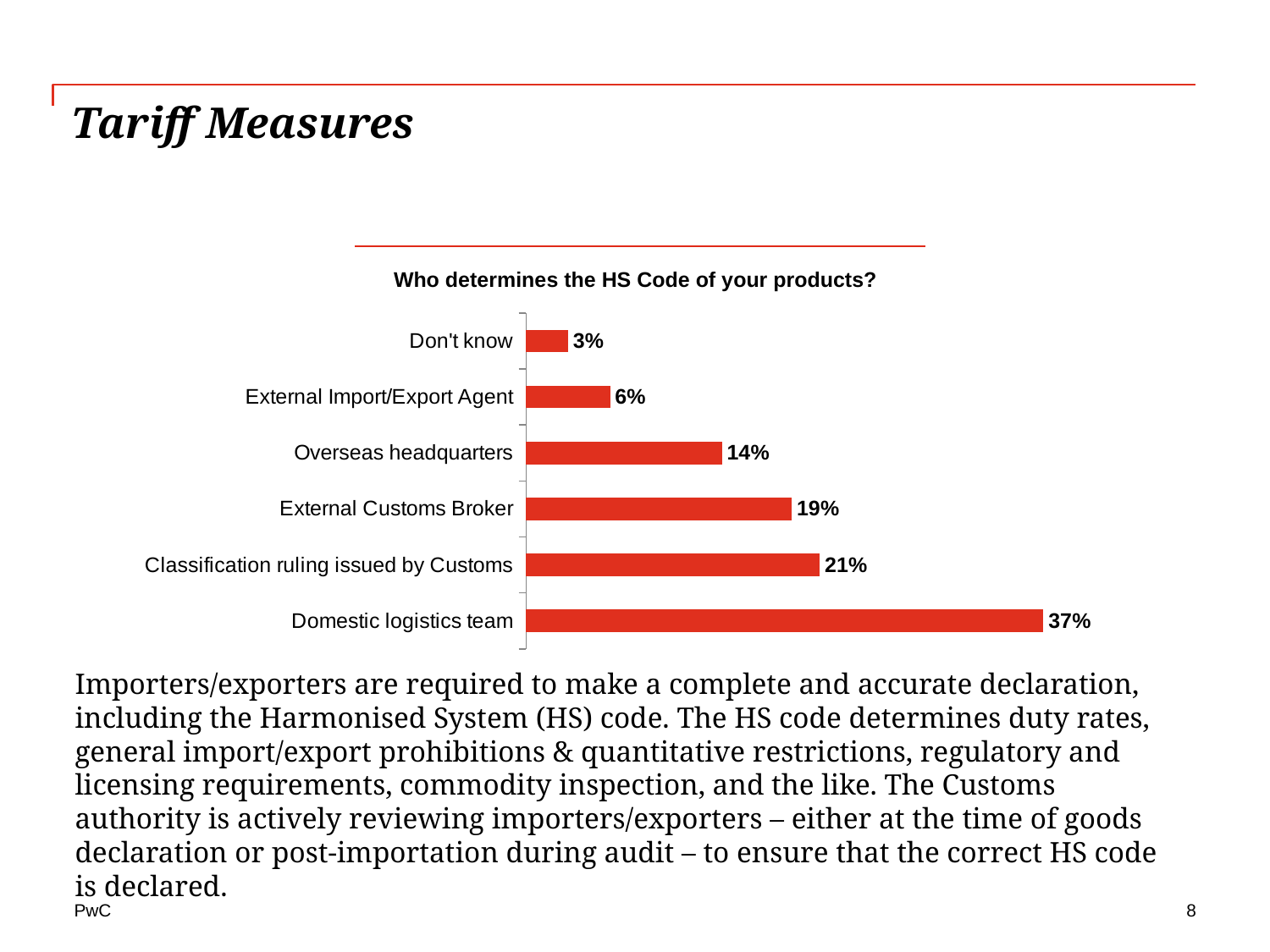
How many categories are shown in the chart? 6 What is the value for Classification ruling issued by Customs? 21% Which category has the highest value in the chart? Domestic logistics team What kind of chart is shown on the slide? Bar chart What percentage of respondents said the Domestic logistics team determines the HS Code of their products? 37% Which is larger: the value for Overseas headquarters or the value for External Customs Broker? External Customs Broker What is the value shown for Overseas headquarters? 14% What is the difference between the values for Domestic logistics team and Classification ruling issued by Customs? 16% Which category has the lowest value in the chart? Don't know What percentage is shown for External Customs Broker? 19% What is the difference between the values for External Customs Broker and External Import/Export Agent? 13% What is the title of the chart? Who determines the HS Code of your products?